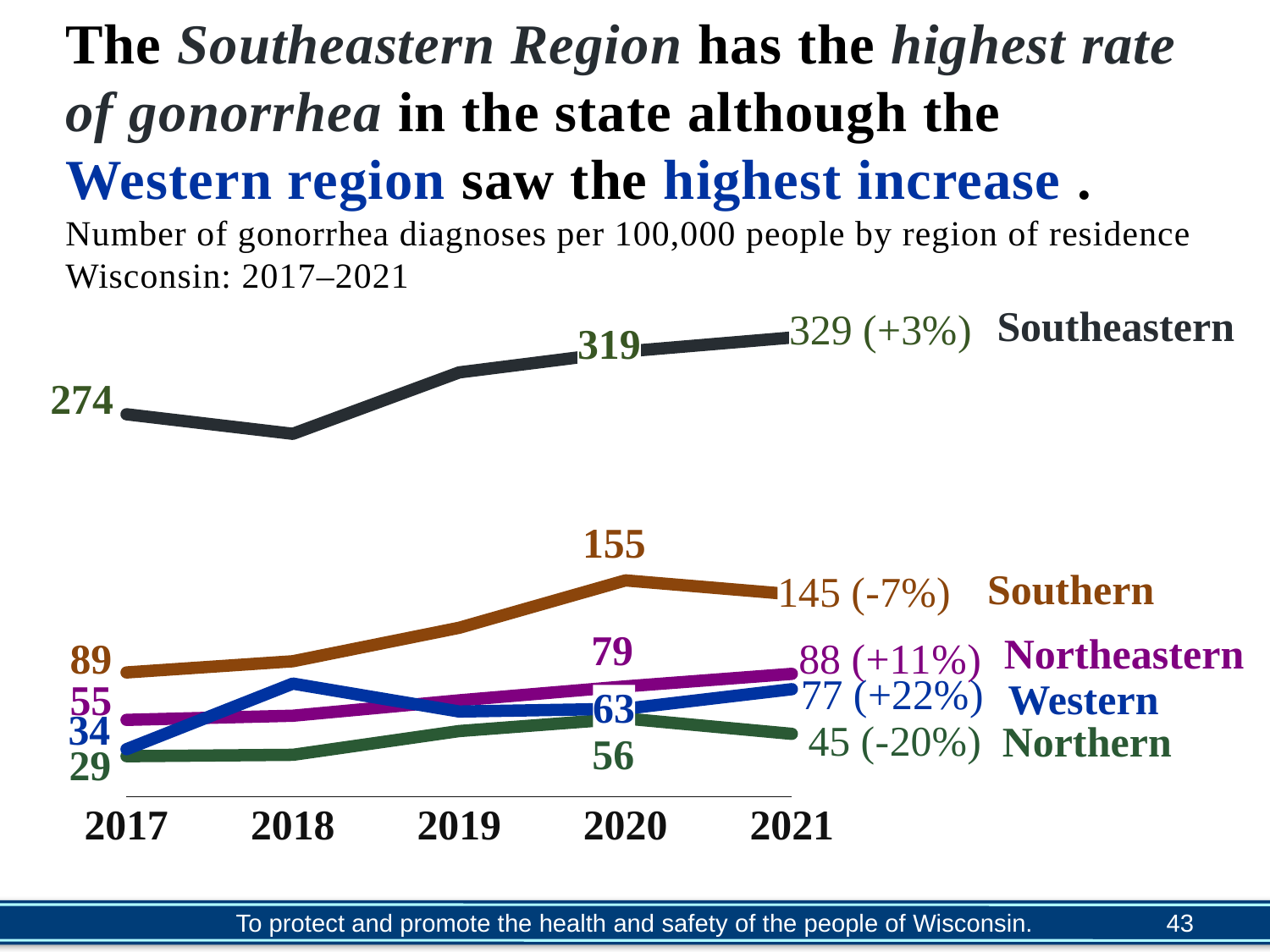
What was the gonorrhea rate per 100,000 in the Southeastern region in 2021? 329 What was the gonorrhea rate per 100,000 in the Western region in 2017? 34 What percent change is shown for the Northern region in 2021? -20% How many years are shown on the x axis? 5 Did the Southern region's rate rise or fall from 2020 to 2021? Fall By how much did the Southeastern region's rate increase from 2017 to 2021? 55 What type of chart is shown on the slide? Line chart How many regions are plotted on the chart? 5 In 2021, which region had a higher rate: Northeastern or Western? Northeastern Which region had the highest gonorrhea rate in 2021? Southeastern Which region had the lowest gonorrhea rate in 2017? Northern What was the gonorrhea rate per 100,000 in the Southern region in 2020? 155